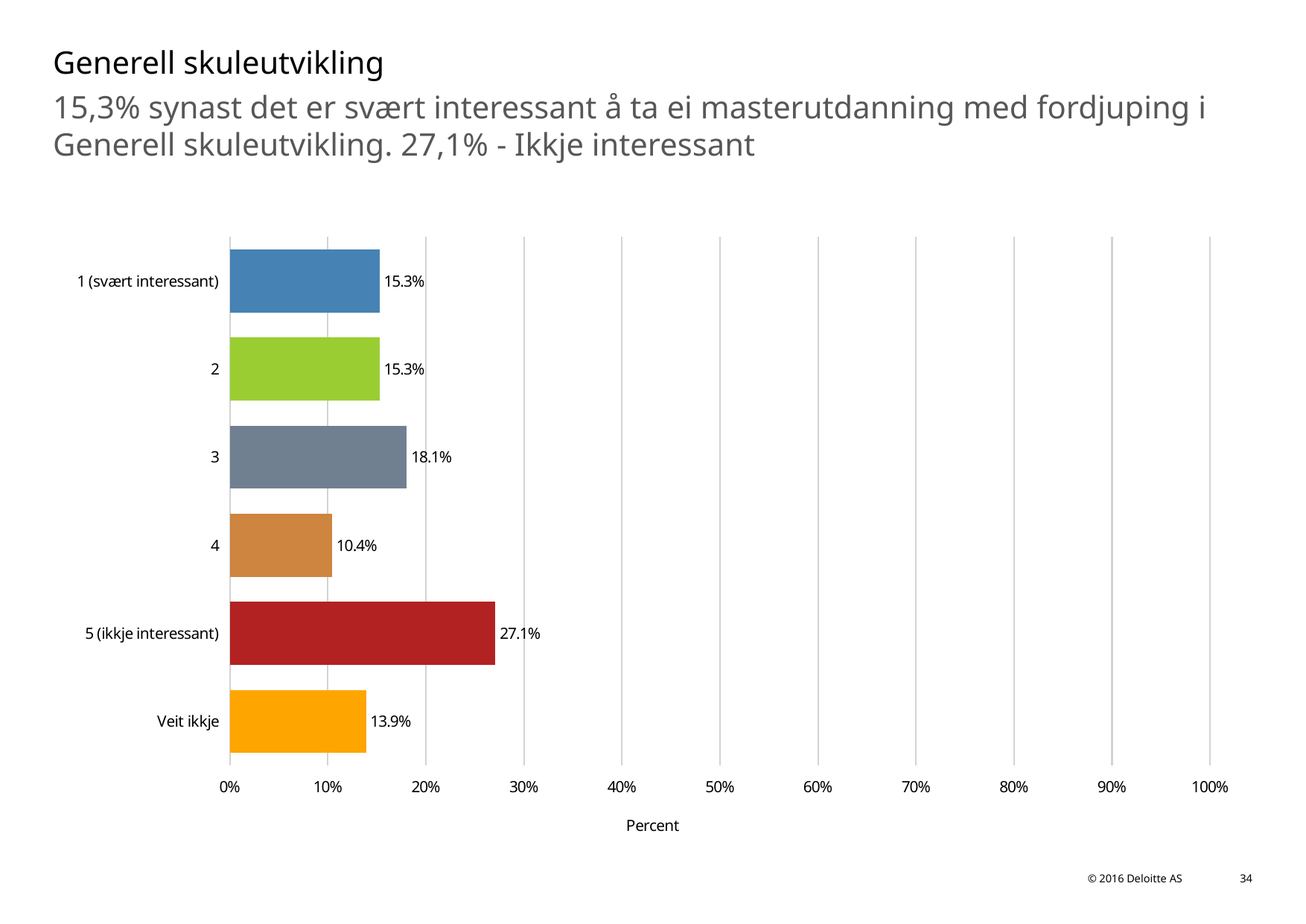
Which category has the highest value? 5 (ikkje interessant) What is the difference between the values for "5 (ikkje interessant)" and "4"? 16.7% What is the value for "3"? 18.1% What is the label of the horizontal axis? Percent Is the value for "5 (ikkje interessant)" greater or less than 20%? greater How many categories are shown in the chart? 6 Which category has the lowest value? 4 What kind of chart is shown on the slide? Bar chart What is the value for "5 (ikkje interessant)"? 27.1% What is the value for "1 (svært interessant)"? 15.3% Which is larger, the value for "3" or the value for "Veit ikkje"? 3 What is the value for "Veit ikkje"? 13.9%